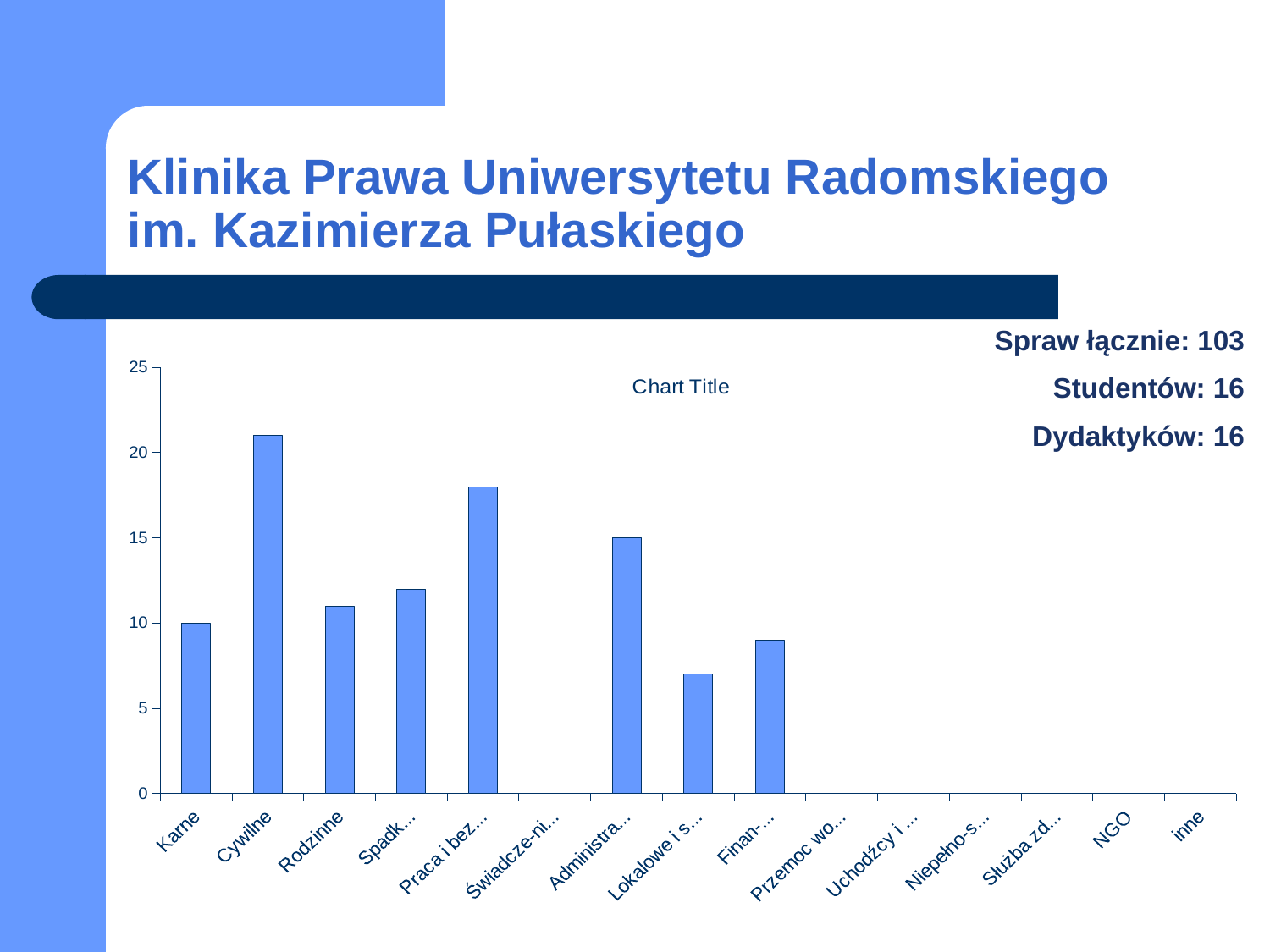
What is the difference between the value for the category beginning 'Administra' and the value for Karne? 5 How many categories are shown on the x axis of the chart? 15 Which category has the highest bar in the chart? Cywilne What is the value for Karne? 10 Which is larger, the value for the category beginning 'Praca i bez' or the value for the category beginning 'Administra'? Praca i bez... Is the value for the category beginning 'Praca i bez' greater or less than 20? less What type of chart is shown on the slide? bar chart Is the value for the category beginning 'Lokalowe i s' greater or less than 10? less Which is larger, the value for Cywilne or the value for the category beginning 'Praca i bez'? Cywilne Is the value for Cywilne greater or less than 20? greater What is the title shown on the chart? Chart Title What is the value for the category whose label begins 'Administra'? 15